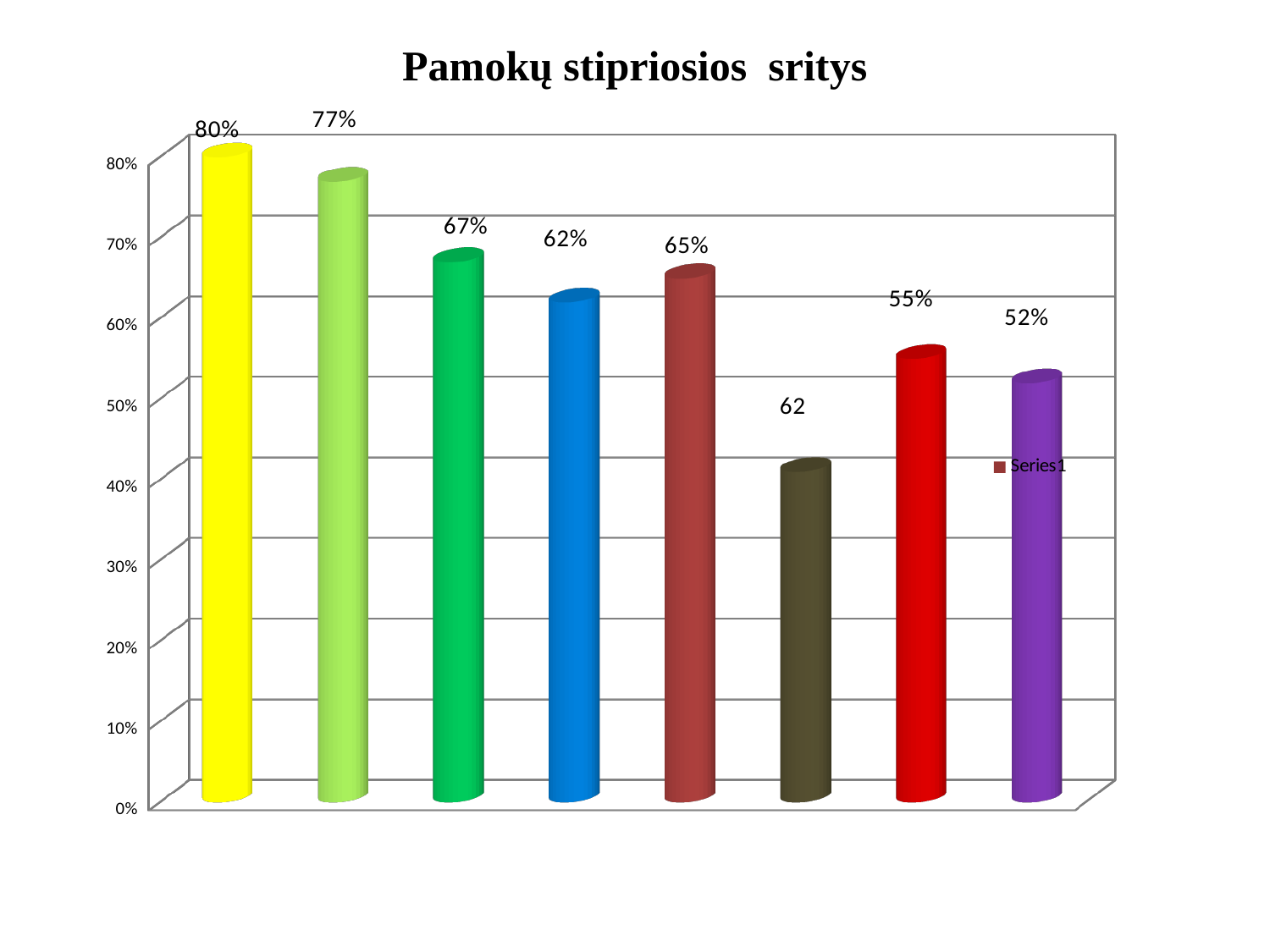
What is the title of the chart? Pamokų stipriosios sritys Is the value of the blue bar greater or less than 60%? greater How many series does the legend list? 1 Which is larger, the value of the light green bar or the dark green bar? the light green bar (77%) How many bars are plotted in the chart? 8 Which bar has the highest value? the first (yellow) bar, 80% What is the value shown on the second (light green) bar? 77% What kind of chart is shown on the slide? bar chart What is the value shown on the red bar, the seventh from the left? 55% What is the difference between the value of the yellow bar and the purple bar? 28 percentage points What is the value shown on the last (purple) bar? 52% What is the value shown on the first (yellow) bar? 80%